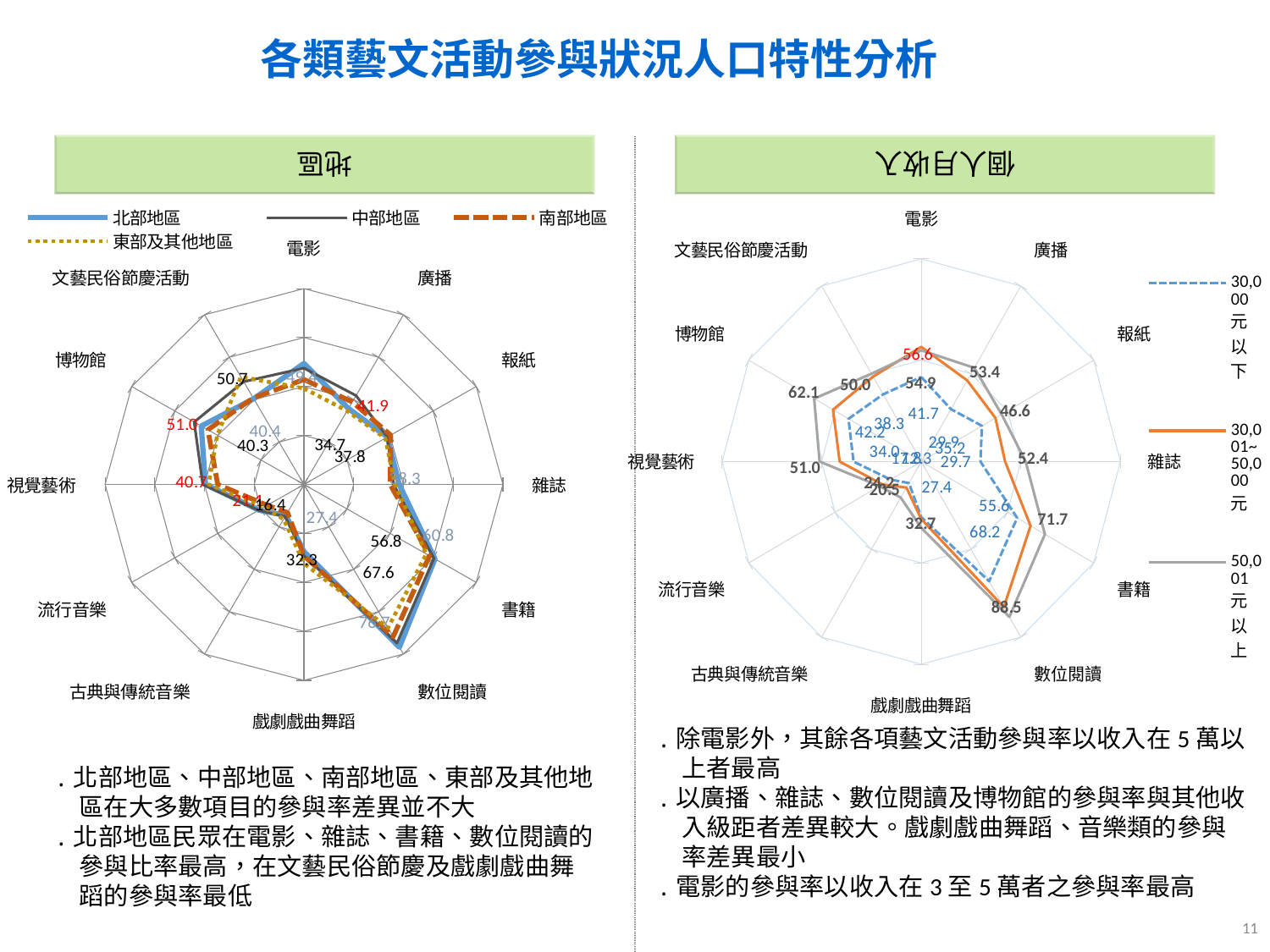
In the right chart (個人月收入), what is the value for 電影 for the 30,001~50,000元 series? 56.6 What kind of chart is the left chart titled 地區? radar chart In the right chart (個人月收入), what is the value for 數位閱讀 for the 30,000元以下 series? 68.2 How many categories (axes) does the right chart (個人月收入) have? 12 How many categories (axes) does the left chart (地區) have? 12 In the right chart (個人月收入), what is the difference between the 50,001元以上 and 30,000元以下 values for 數位閱讀? 20.3 Which series in the left chart (地區) is drawn with a dotted yellow line? 東部及其他地區 In the right chart (個人月收入), which category has the highest value for the 50,001元以上 series? 數位閱讀 What is the title of the left chart? 地區 How many series does the legend of the left chart (地區) list? 4 In the right chart (個人月收入), what is the value for 數位閱讀 for the 50,001元以上 series? 88.5 How many series does the legend of the right chart (個人月收入) list? 3